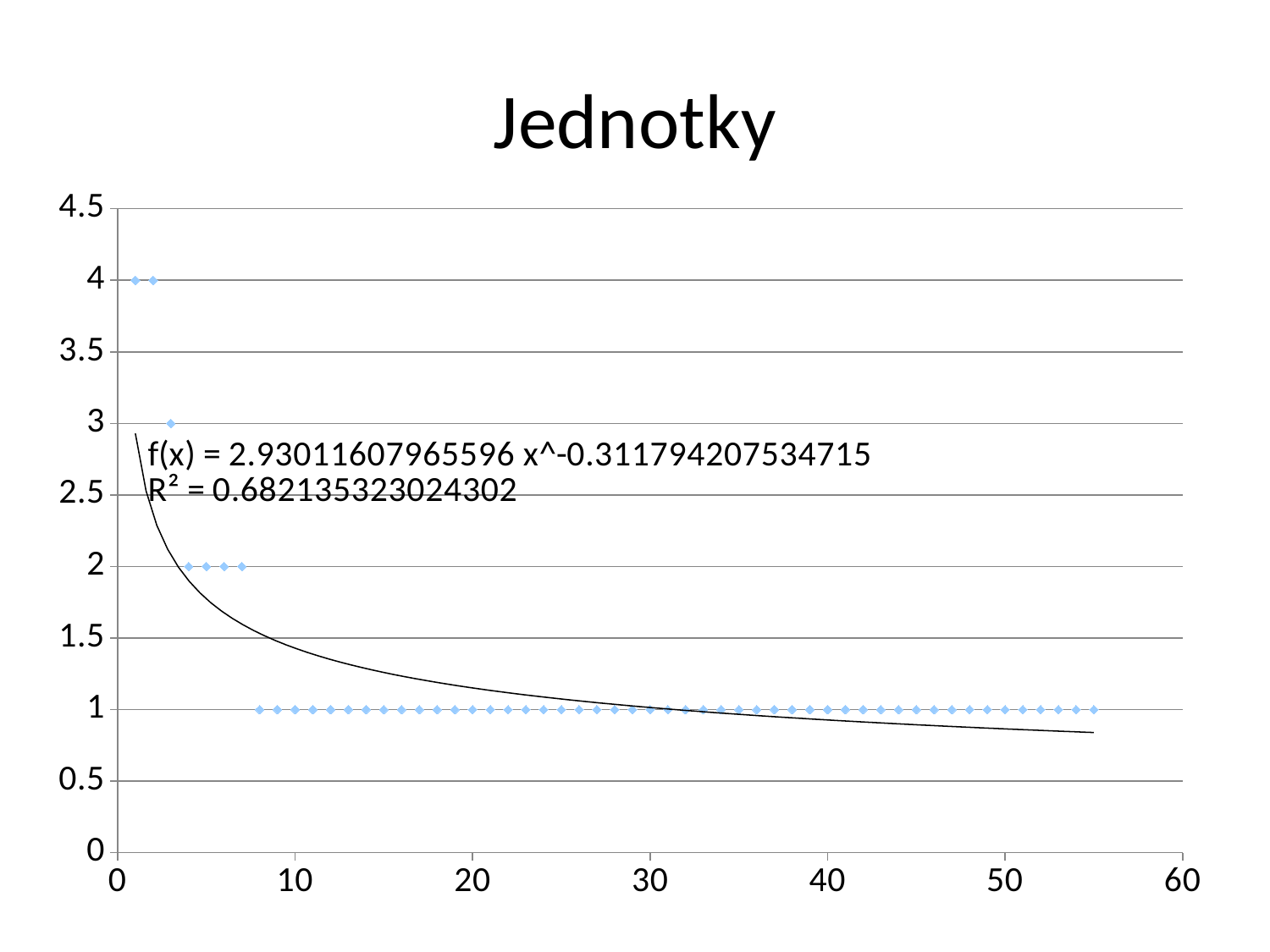
What R² value is printed on the chart for the trendline? R² = 0.682135323024302 What is the y value of the point at x = 1? 4 What is the lowest y value reached by the plotted points? 1 What is the highest y value reached by the plotted points? 4 How many points lie on the y = 4 gridline? 2 How many points lie on the y = 2 gridline? 4 Is the y value of the point at x = 20 greater or less than 1.5? less What kind of chart is shown on the slide? scatter chart What is the y value of the point at x = 3? 3 What is the title of the chart? Jednotky Do the plotted values rise or fall as x increases? fall Which point has the larger y value: the one at x = 3 or the one at x = 5? x = 3